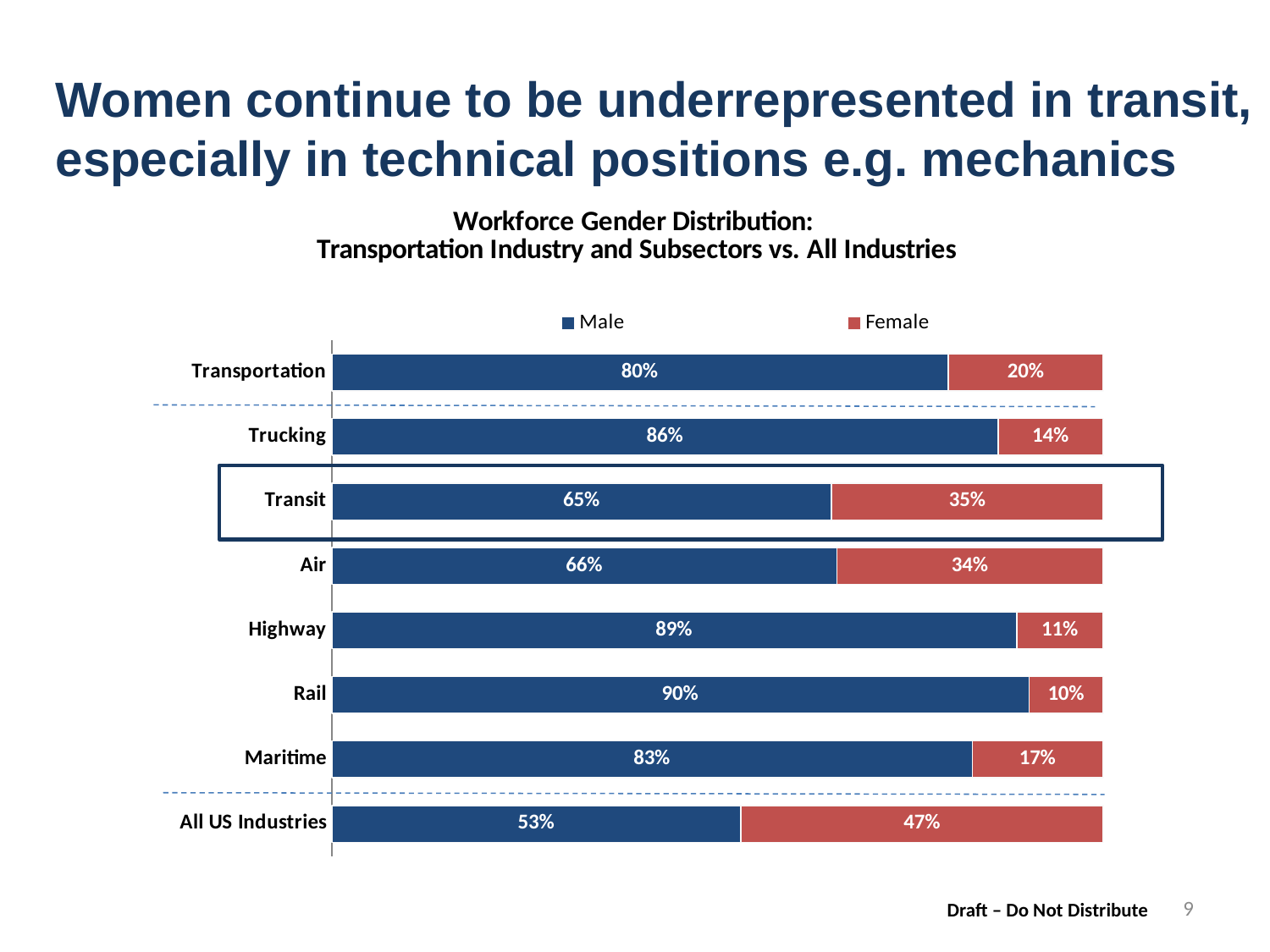
What is the Female share for Transit? 35% What kind of chart is shown on the slide? Stacked bar chart What is the Male share for Rail? 90% How many categories are shown on the chart? 8 What is the difference between the Female share for Transit and the Female share for Trucking? 21% Which has a larger Female share, Air or Maritime? Air How many series does the legend list? 2 Which category has the highest Male share? Rail What is the total of the Male and Female shares for Highway? 100% Which series is shown in red? Female Which category has the lowest Female share? Rail What is the Female share for All US Industries? 47%